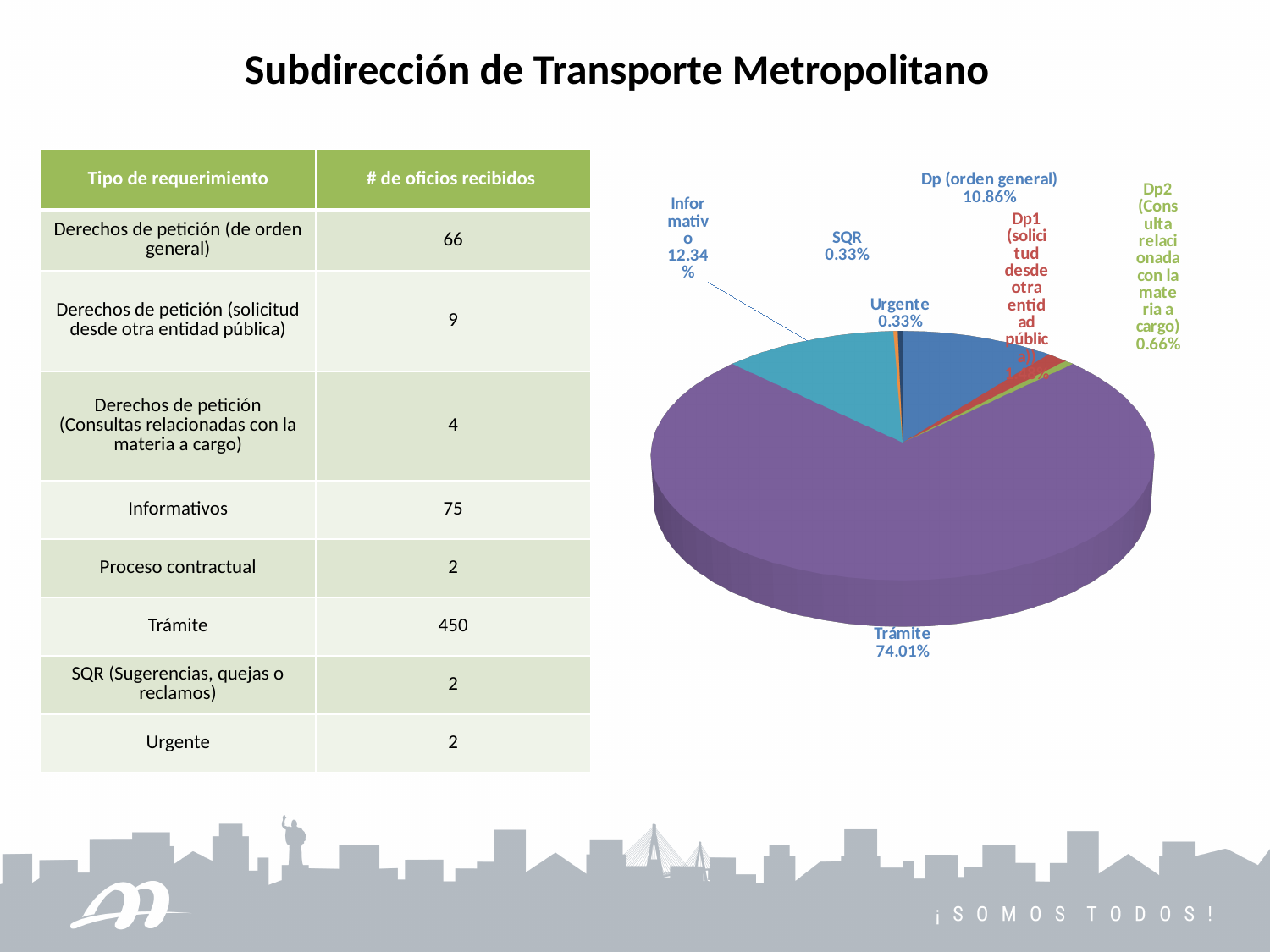
In the pie chart, which is larger: Informativo or Dp (orden general)? Informativo What kind of chart is shown on the right side of the slide? pie chart In the pie chart, what share does Trámite have? 74.01% In the pie chart, what is the difference between the shares of Trámite and Informativo? 61.67% Which slice of the pie chart is the largest? Trámite What colour is the Trámite slice in the pie chart? purple In the pie chart, what share does Urgente have? 0.33% In the pie chart, what share does Dp2 (Consulta relacionada con la materia a cargo) have? 0.66% In the pie chart, what share does SQR have? 0.33% In the pie chart, what share does Dp (orden general) have? 10.86% In the pie chart, what is the difference between the shares of Informativo and Dp (orden general)? 1.48% In the pie chart, what share does Informativo have? 12.34%